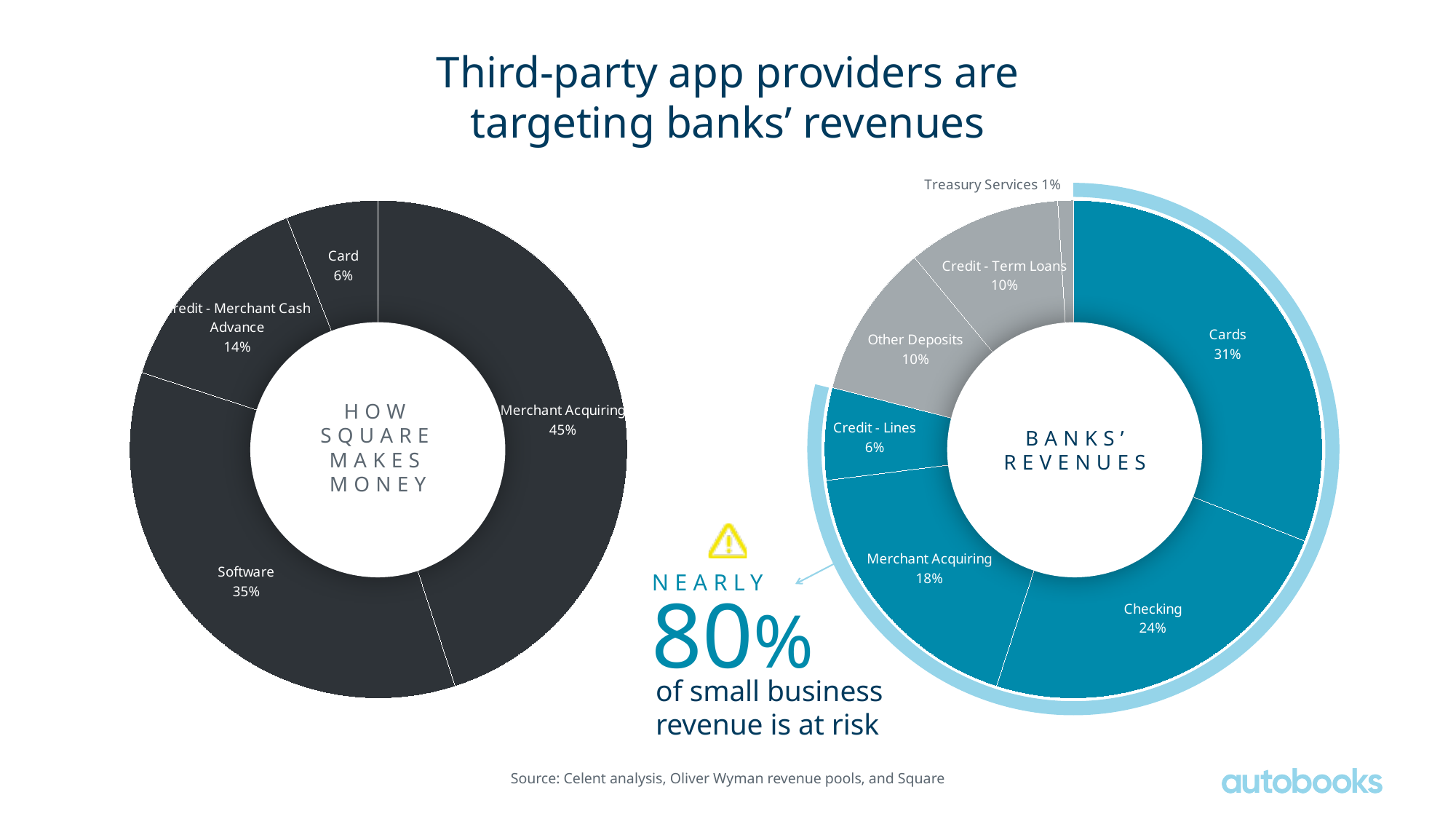
In the 'How Square Makes Money' chart, what is the difference between Merchant Acquiring and Software? 10% In the 'How Square Makes Money' chart, what is the value for Software? 35% In the 'Banks' Revenues' chart, how many categories are shown? 7 In the 'Banks' Revenues' chart, which category has the smallest share? Treasury Services In the 'Banks' Revenues' chart, which is larger: Merchant Acquiring or Credit - Lines? Merchant Acquiring In the 'How Square Makes Money' chart, which category has the smallest share? Card In the 'Banks' Revenues' chart, what share do Cards account for? 31% In the 'Banks' Revenues' chart, which category has the largest share? Cards What type of chart is used for 'How Square Makes Money'? Donut (pie) chart In the 'How Square Makes Money' chart, how many categories are shown? 4 In the 'Banks' Revenues' chart, what is the value for Checking? 24% In the 'How Square Makes Money' chart, what share does Merchant Acquiring account for? 45%